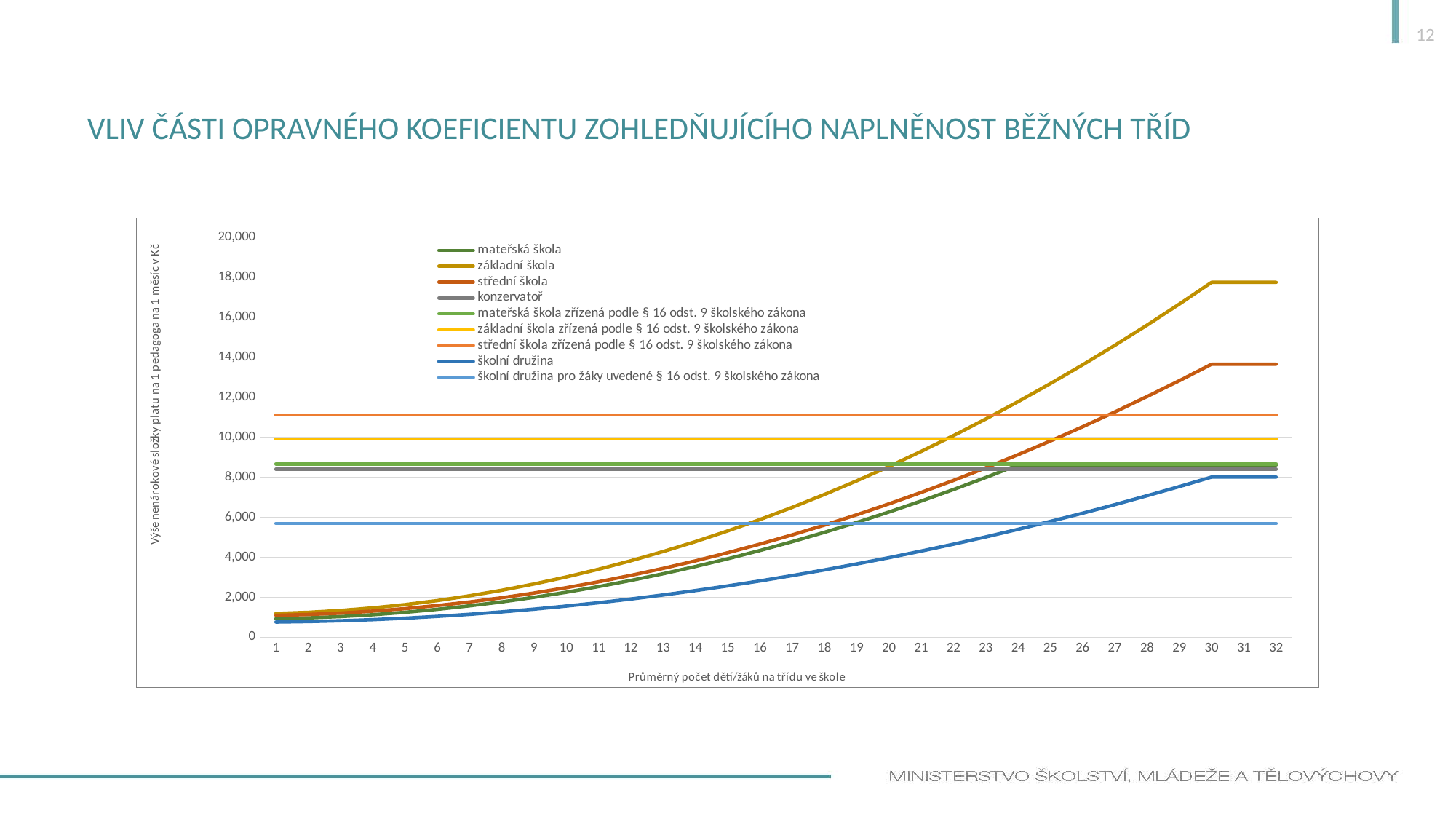
Which series has the highest value at 32 pupils per class? základní škola Is the value for základní škola at 32 pupils per class greater or less than 16,000? greater How many points are on the x axis (average number of children/pupils per class)? 32 At 32 pupils per class, which is larger: základní škola or střední škola? základní škola How many series does the legend list? 9 Is the value for školní družina pro žáky uvedené § 16 odst. 9 školského zákona greater or less than 6,000? less Is the value for střední škola zřízená podle § 16 odst. 9 školského zákona greater or less than 10,000? greater Which series has the lowest value at 32 pupils per class? školní družina pro žáky uvedené § 16 odst. 9 školského zákona What is the title of the x axis? Průměrný počet dětí/žáků na třídu ve škole Does the value for základní škola rise or fall as the number of pupils per class increases from 1 to 30? rises What kind of chart is shown on the slide? line chart